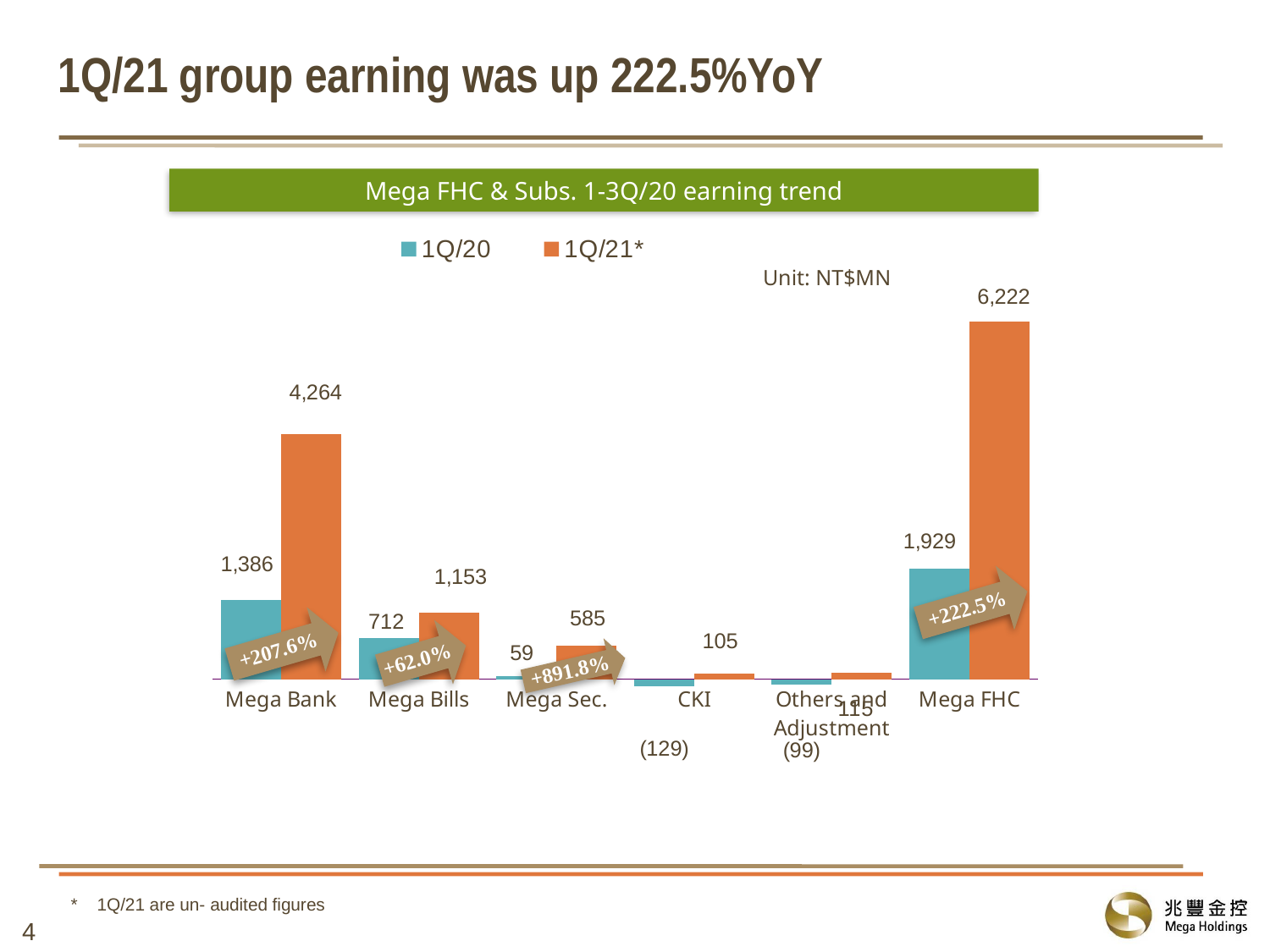
How many series does the chart legend list? 2 What is the 1Q/20 value for Mega FHC? 1,929 Which is larger: the 1Q/21* value for Mega Bills or the 1Q/21* value for Mega Sec.? Mega Bills Which category has the highest 1Q/21* value? Mega FHC How many categories are shown on the x axis of the chart? 6 What is the difference between the 1Q/21* and 1Q/20 values for Mega Bank? 2,878 What is the 1Q/20 value for CKI? (129) What is the difference between the 1Q/21* and 1Q/20 values for Mega FHC? 4,293 What is the 1Q/20 value for Mega Sec.? 59 What is the 1Q/21* value for Mega Bank? 4,264 Which category has the lowest 1Q/20 value? CKI What type of chart is shown on the slide? Bar chart